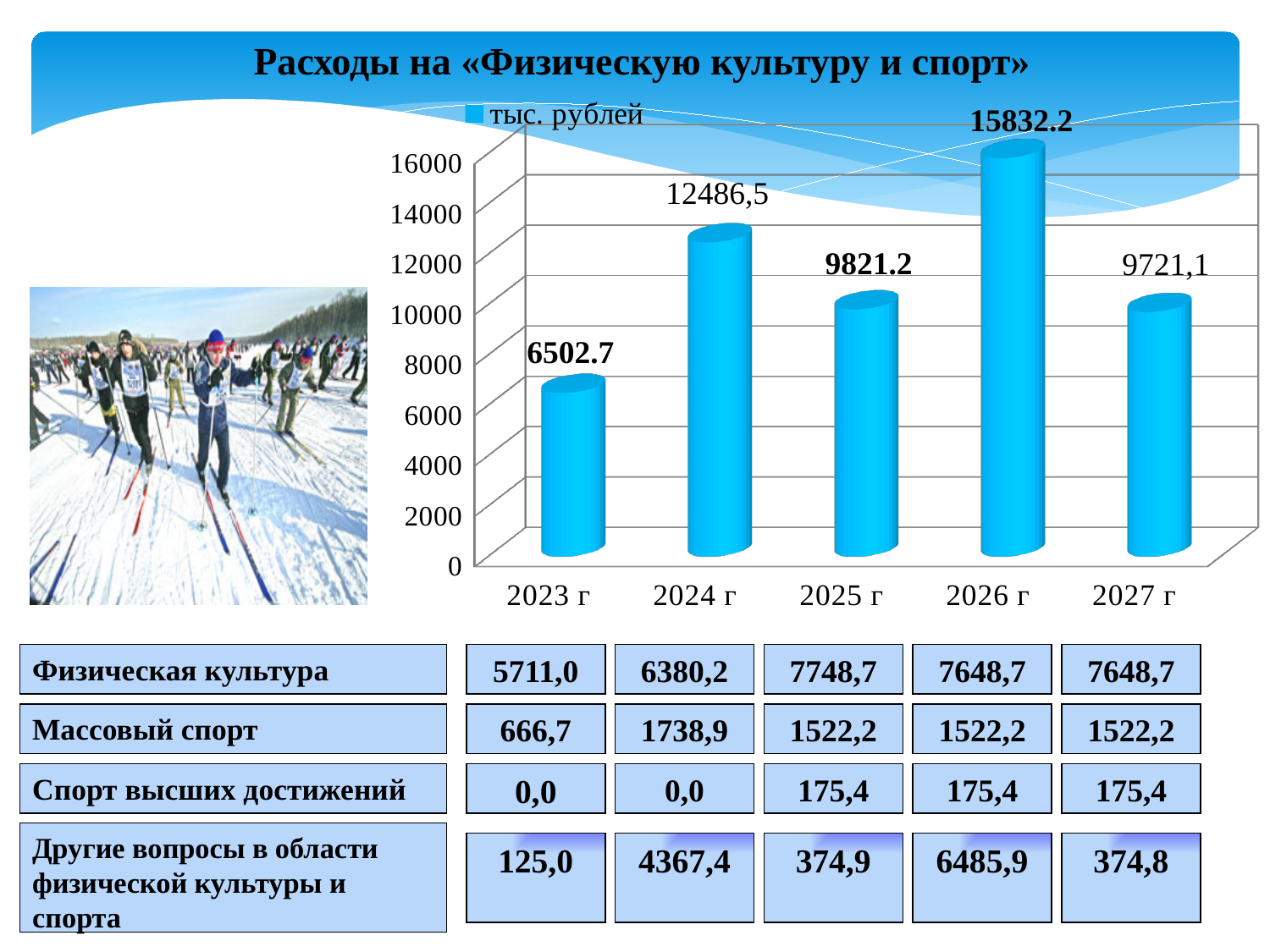
Is the value for 2023 г greater or less than 8000? less How many years are shown on the x axis of the chart? 5 What is the value for 2023 г in the chart? 6502.7 What is the value for 2024 г in the chart? 12486,5 What is the value for 2026 г in the chart? 15832.2 What is the value for 2027 г in the chart? 9721,1 What is the legend entry of the chart? тыс. рублей What kind of chart is shown on the slide? bar chart Which year has the lowest value in the chart? 2023 г Which year has the highest value in the chart? 2026 г What is the difference between the values for 2026 г and 2023 г? 9329.5 Which is larger, the value for 2024 г or the value for 2025 г? 2024 г